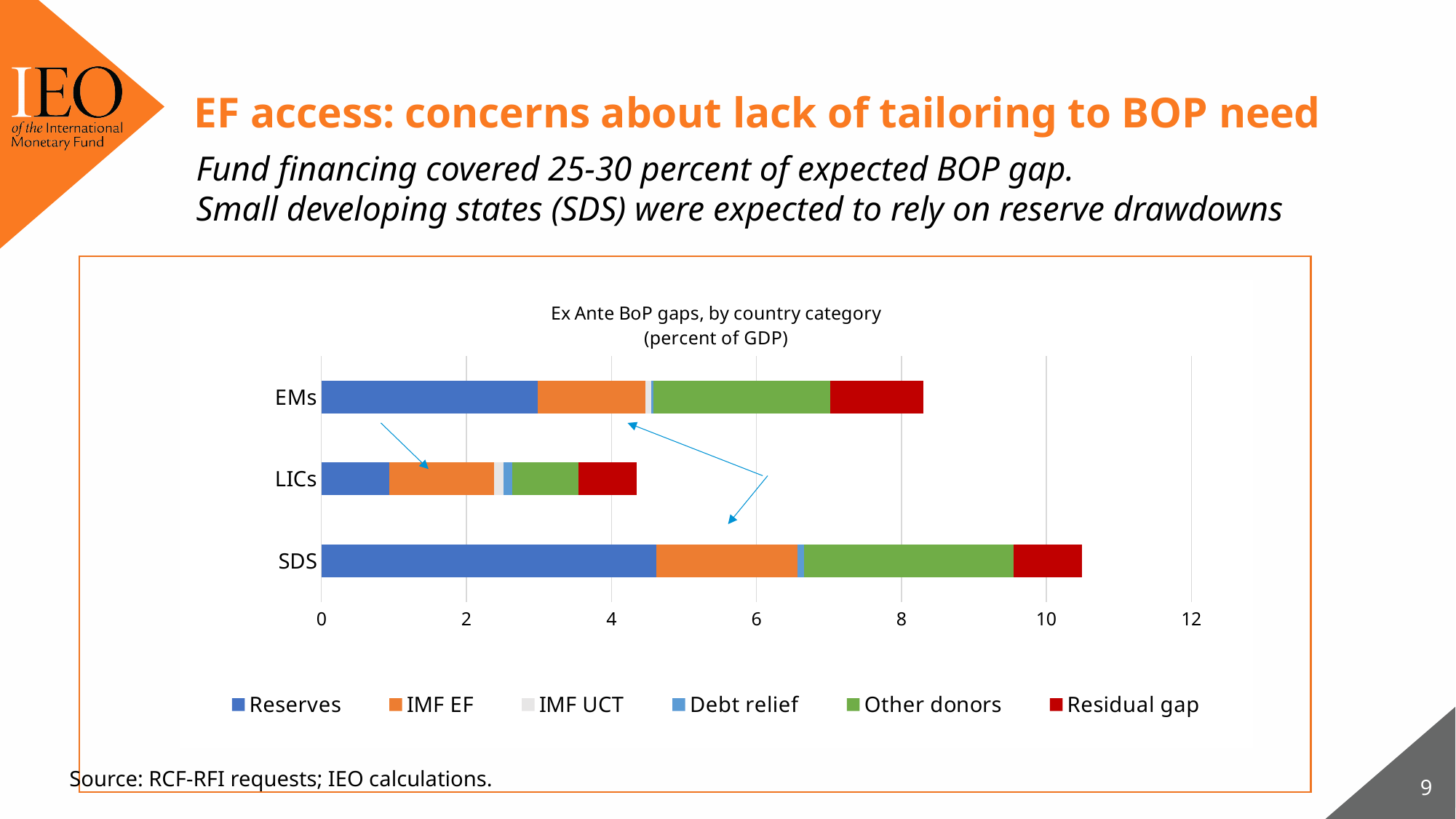
Is the Reserves segment for SDS greater or less than 4? greater What kind of chart is shown on the slide? Stacked bar chart Is the total bar for EMs greater or less than 10? less Is the total bar for SDS greater or less than 10? greater How many series does the chart legend list? 6 Which country category has the smallest total ex ante BoP gap? LICs How many country categories are plotted in the chart? 3 Which country category has the largest Reserves segment? SDS Which has the larger total BoP gap, EMs or SDS? SDS What is the title of the chart? Ex Ante BoP gaps, by country category (percent of GDP) Which country category has the largest total ex ante BoP gap? SDS